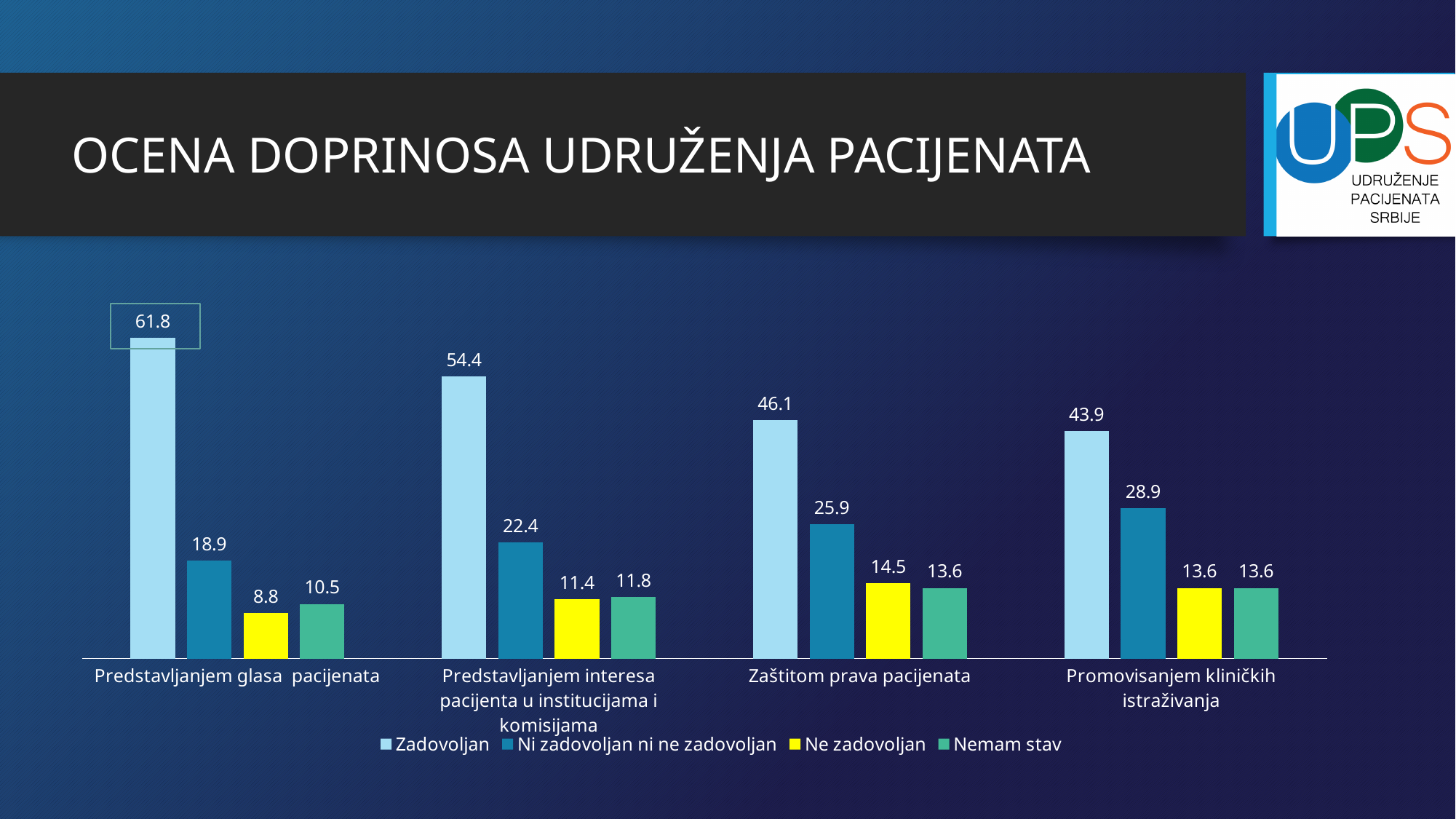
What is the value for Nemam stav in the category Predstavljanjem interesa pacijenta u institucijama i komisijama? 11.8 What is the value for Ni zadovoljan ni ne zadovoljan in the category Promovisanjem kliničkih istraživanja? 28.9 Which is larger: Ni zadovoljan ni ne zadovoljan for Zaštitom prava pacijenata or for Predstavljanjem interesa pacijenta u institucijama i komisijama? Zaštitom prava pacijenata What is the difference between the Zadovoljan values for Predstavljanjem glasa pacijenata and Promovisanjem kliničkih istraživanja? 17.9 What kind of chart is shown on the slide? Bar chart Do the Zadovoljan values rise or fall from left to right across the categories? Fall How many categories are shown on the x axis? 4 Which category has the highest value for Zadovoljan? Predstavljanjem glasa pacijenata What is the value for Ne zadovoljan in the category Zaštitom prava pacijenata? 14.5 Which category has the lowest value for Ne zadovoljan? Predstavljanjem glasa pacijenata What is the value for Zadovoljan in the category Predstavljanjem glasa pacijenata? 61.8 How many series does the legend list? 4